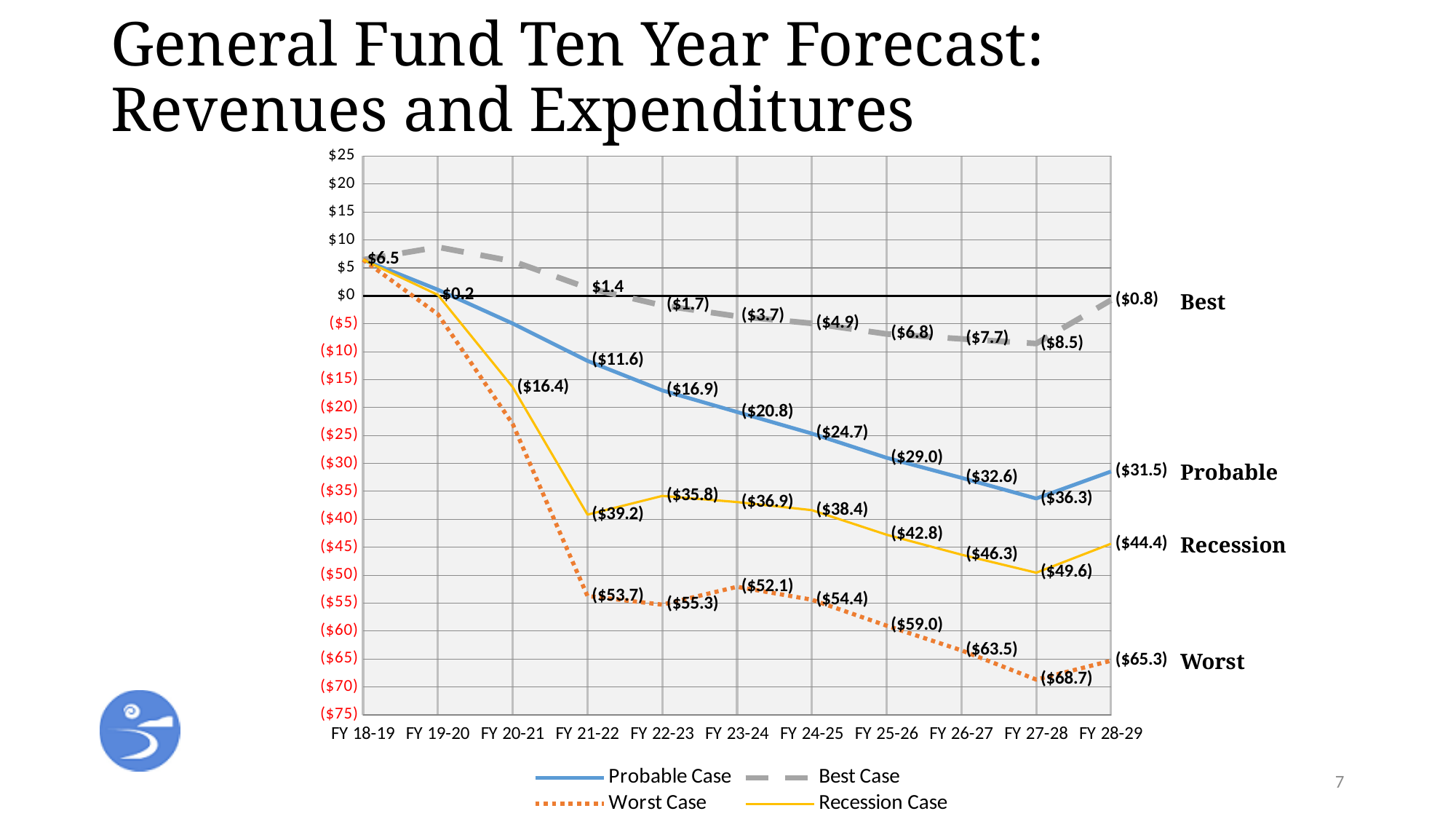
What is the Best Case value for FY 28-29? ($0.8) Which series is drawn as a gray dashed line? Best Case What is the difference between the Best Case ($0.8) and Probable Case ($31.5) values in FY 28-29? $30.7 What is the Probable Case value for FY 27-28? ($36.3) What is the Worst Case value for FY 27-28? ($68.7) What kind of chart is shown on the slide? Line chart How many fiscal years are shown on the x axis? 11 How many series does the legend list? 4 What is the Recession Case value for FY 21-22? ($39.2) In which fiscal year does the Worst Case line reach its lowest value? FY 27-28 Which series has the highest value in FY 28-29? Best Case Is the Best Case value for FY 19-20 greater or less than $5? greater